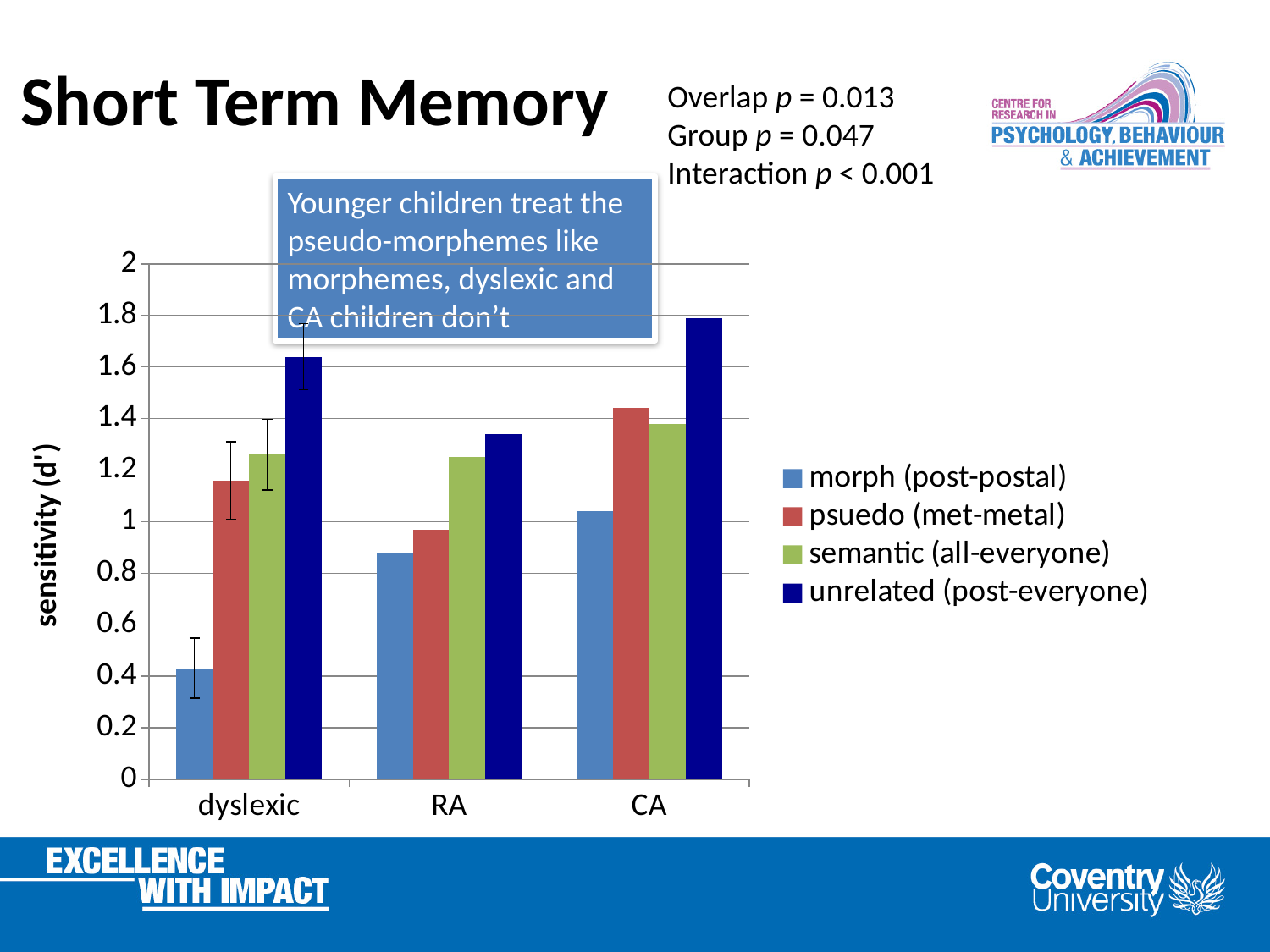
Is the morph (post-postal) value for the dyslexic group greater or less than 0.6? less What kind of chart is shown on the slide? bar chart Is the unrelated (post-everyone) value for the dyslexic group greater or less than 1.4? greater Which group and series has the shortest bar in the chart? morph (post-postal) for dyslexic How many series does the legend list? 4 Within the dyslexic group, which series has the highest sensitivity? unrelated (post-everyone) Within the CA group, which series has the lowest sensitivity? morph (post-postal) What is the label on the y axis? sensitivity (d') Which group and series has the tallest bar in the chart? unrelated (post-everyone) for CA How many groups are shown on the x axis? 3 Which is larger: the morph (post-postal) value for dyslexic or for RA? RA Is the morph (post-postal) value for the RA group greater or less than 1? less